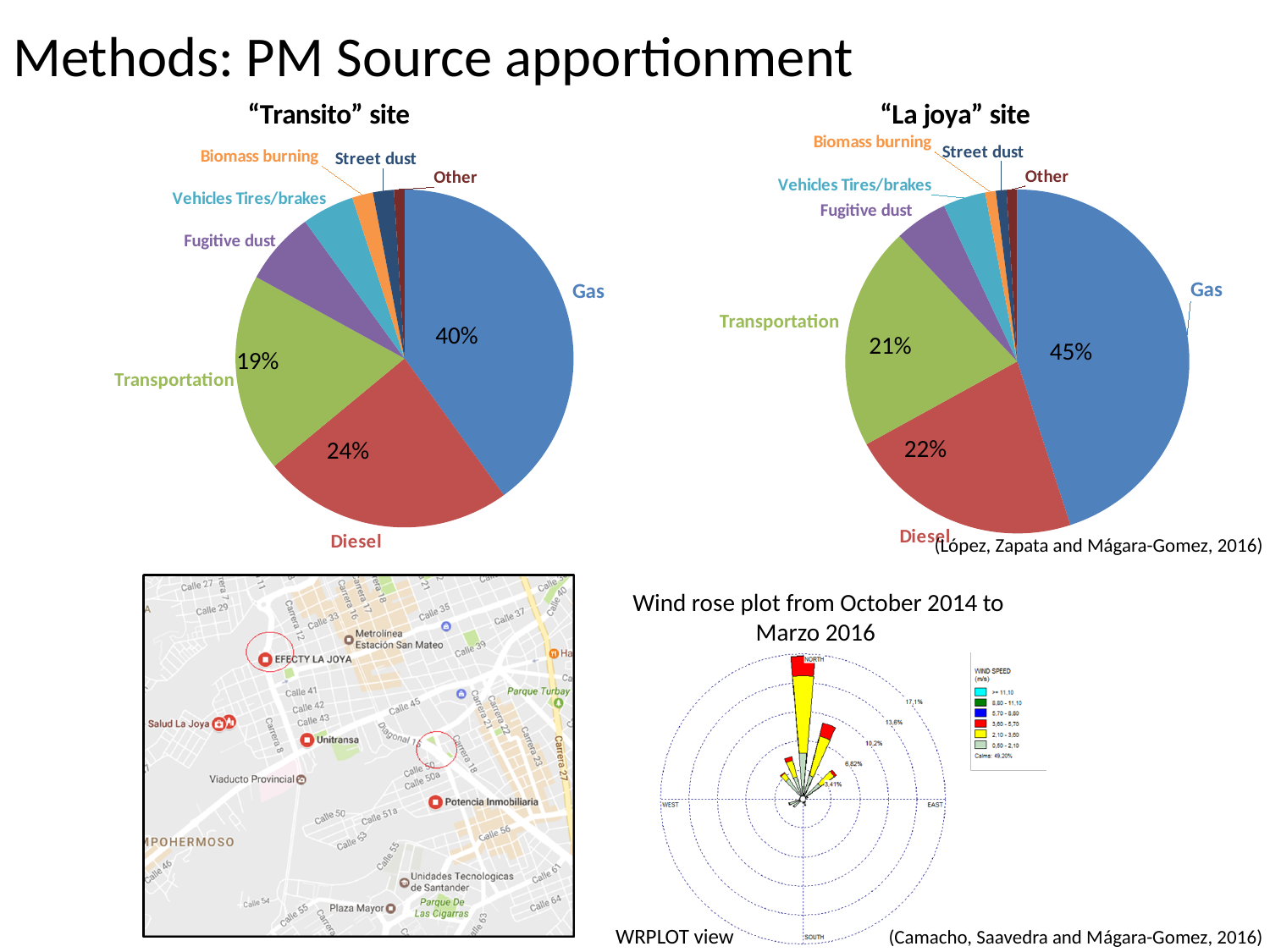
In the "Transito" site pie chart, what share does Diesel account for? 24% Which site has the larger Gas share, "Transito" or "La joya"? La joya How many source categories are shown in the "La joya" site pie chart? 8 In the "La joya" site pie chart, which source has the largest slice? Gas In the "Transito" site pie chart, what share does Gas account for? 40% In the "Transito" site pie chart, what share does Transportation account for? 19% In the "La joya" site pie chart, what share does Gas account for? 45% In the "Transito" site pie chart, which source has the largest slice? Gas In the "La joya" site pie chart, what share does Diesel account for? 22% What type of chart is used to show the PM source apportionment for the "Transito" site? Pie chart What is the difference between the Gas share and the Diesel share in the "Transito" site pie chart? 16% In the "La joya" site pie chart, what share does Transportation account for? 21%